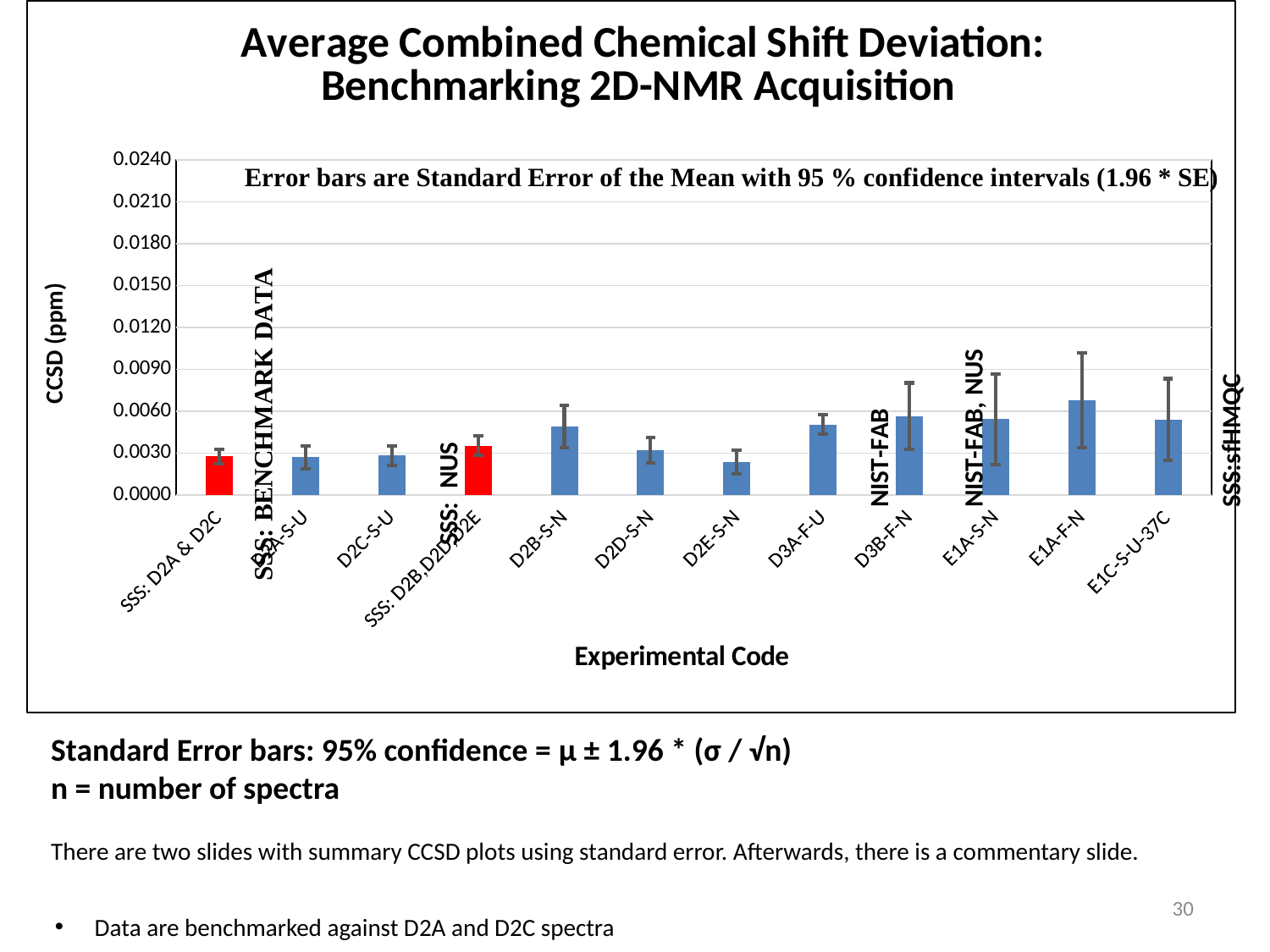
Which has the larger CCSD value, E1A-F-N or D2E-S-N? E1A-F-N Which experimental code has the highest CCSD value? E1A-F-N Is the CCSD value for D2E-S-N greater or less than 0.0030? less Which experimental code has the lowest CCSD value? D2E-S-N How many bars are coloured red? 2 Which has the larger CCSD value, D2B-S-N or D2D-S-N? D2B-S-N Is the CCSD value for E1A-F-N greater or less than 0.0060? greater Is the CCSD value for D3B-F-N greater or less than 0.0030? greater How many experimental codes (bars) are plotted on the x axis? 12 What kind of chart is shown on the slide? bar chart What is the label of the y axis? CCSD (ppm)